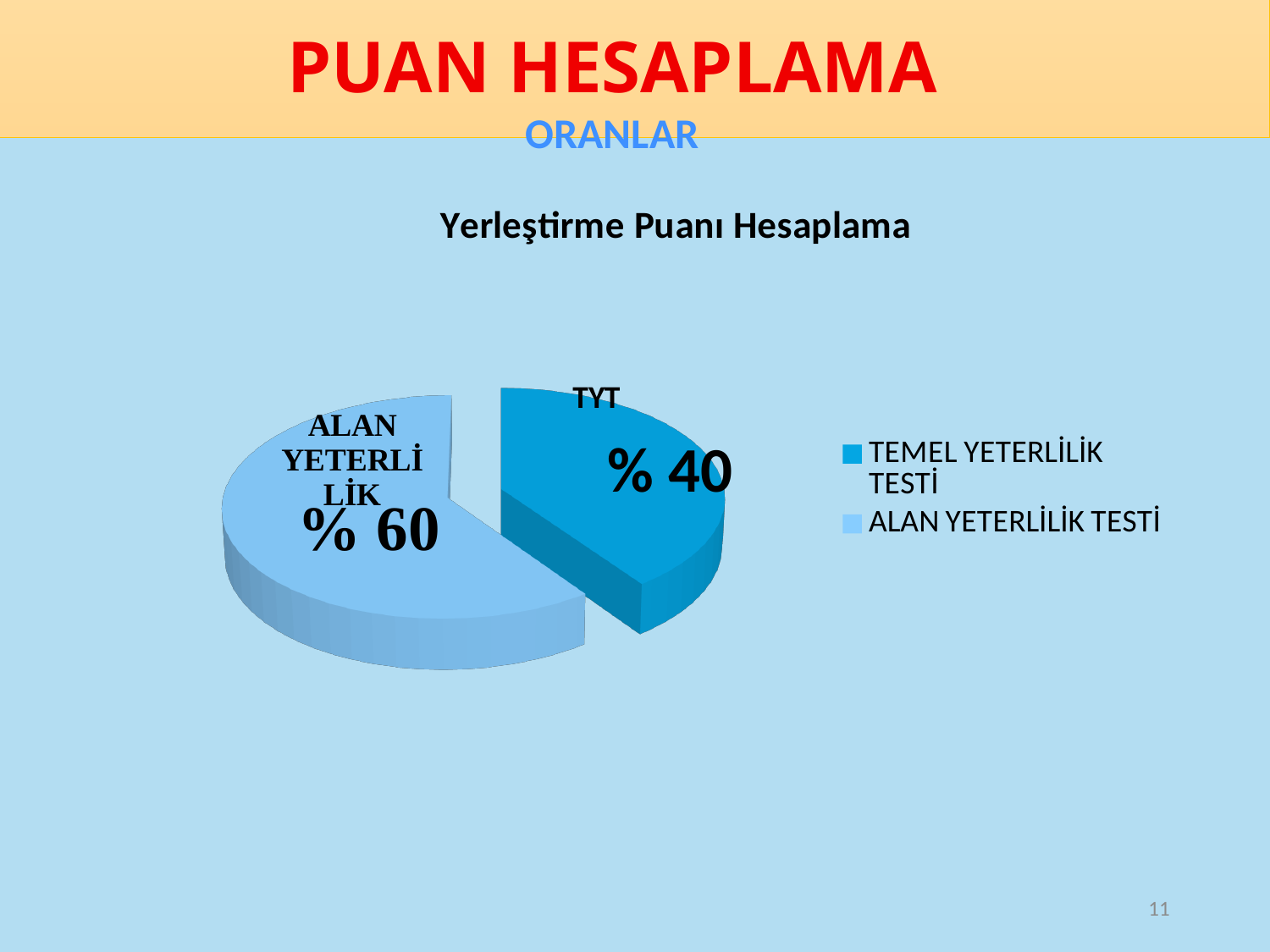
What is the title of the chart? Yerleştirme Puanı Hesaplama What is the difference in percentage points between the ALAN YETERLİLİK slice and the TYT slice? 20 What share of the pie does the TYT slice represent? % 40 Which is larger, the TYT slice or the ALAN YETERLİLİK slice? ALAN YETERLİLİK What share of the pie does the ALAN YETERLİLİK slice represent? % 60 How many slices does the pie chart have? 2 Which slice of the pie is the largest? ALAN YETERLİLİK Which slice of the pie is the smallest? TYT What kind of chart is shown on the slide? Pie chart How many entries does the legend list? 2 Which legend entry is shown with the darker blue colour? TEMEL YETERLİLİK TESTİ